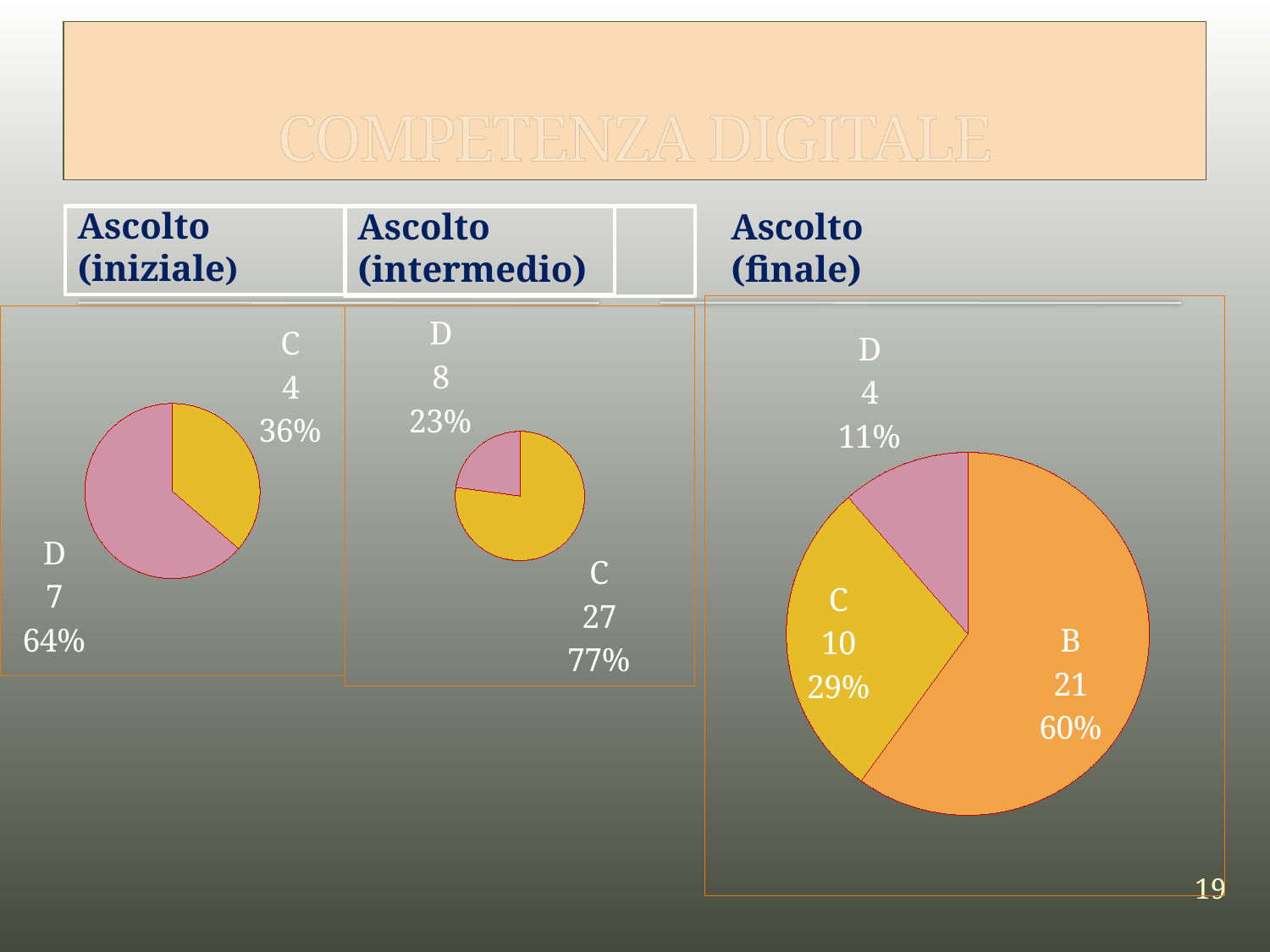
In the Ascolto (finale) chart, how many slices does the pie have? 3 In the Ascolto (intermedio) chart, what value is shown for category C? 27 In the Ascolto (iniziale) chart, what share of the pie does category C have? 36% In the Ascolto (finale) chart, which category has the smallest slice? D In the Ascolto (finale) chart, which category has the largest slice? B In the Ascolto (iniziale) chart, what value is shown for category D? 7 In the Ascolto (iniziale) chart, which is larger, the value for C or the value for D? D In the Ascolto (intermedio) chart, what is the difference between the values for C and D? 19 What kind of chart is the Ascolto (iniziale) chart? Pie chart In the Ascolto (finale) chart, what value is shown for category B? 21 In the Ascolto (finale) chart, what share of the pie does category C have? 29% In the Ascolto (intermedio) chart, what share of the pie does category D have? 23%